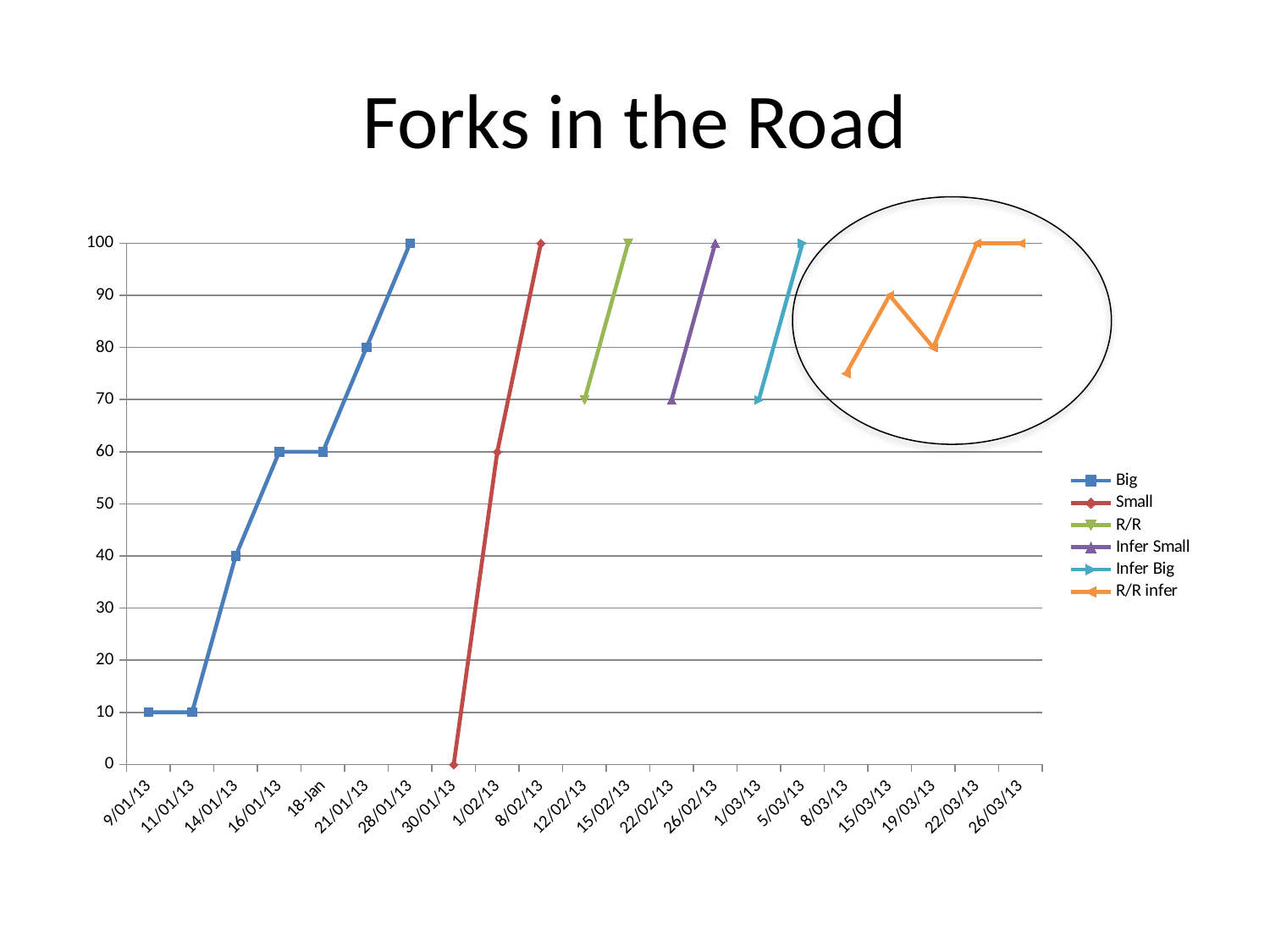
How many date categories are shown on the x axis? 21 How many series does the legend list? 6 What is the value of the Small series on 30/01/13? 0 Is the value of the R/R infer series on 8/03/13 greater or less than 70? greater Which is larger: the Big series value on 16/01/13 or the Big series value on 14/01/13? 16/01/13 What is the value of the R/R infer series on 15/03/13? 90 What is the difference between the Big series values on 21/01/13 and 14/01/13? 40 What is the value of the Big series on 28/01/13? 100 What is the value of the Big series on 9/01/13? 10 What is the title of the slide containing the chart? Forks in the Road What kind of chart is shown on the slide? Line chart Do the values of the Big series rise or fall from 9/01/13 to 28/01/13? Rise